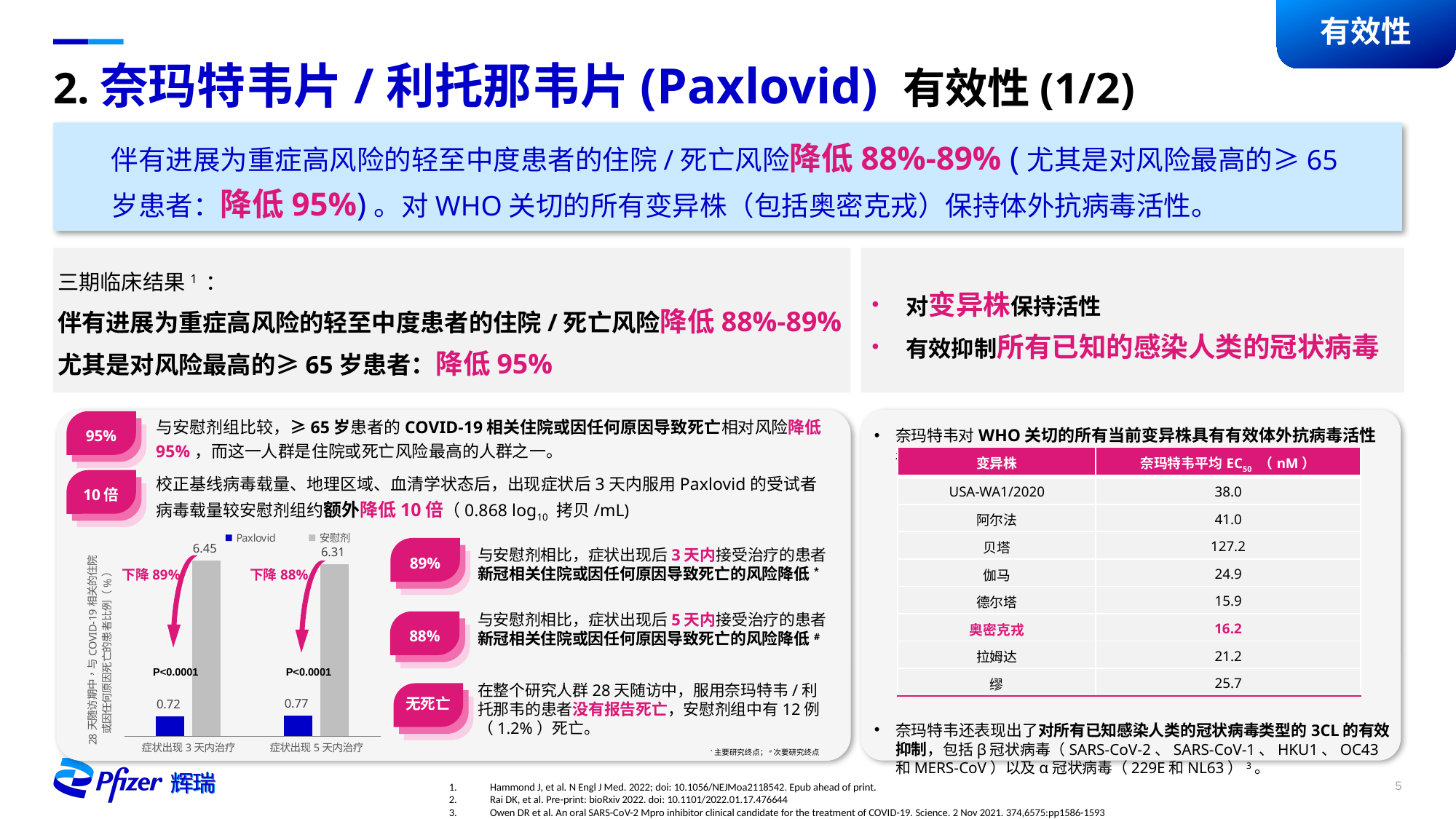
In the bar chart, what is the value for Paxlovid in the 症状出现 5 天内治疗 group? 0.77 In the bar chart, which bar has the highest value? 安慰剂, 症状出现 3 天内治疗 (6.45) In the bar chart, what is the value for 安慰剂 in the 症状出现 5 天内治疗 group? 6.31 In the bar chart, which bar has the lowest value? Paxlovid, 症状出现 3 天内治疗 (0.72) In the bar chart, what is the value for 安慰剂 in the 症状出现 3 天内治疗 group? 6.45 In the bar chart, what is the difference between the 安慰剂 and Paxlovid values in the 症状出现 3 天内治疗 group? 5.73 How many series does the legend of the bar chart list? 2 What type of chart is shown at the bottom left of the slide? bar chart In the bar chart, what is the value for Paxlovid in the 症状出现 3 天内治疗 group? 0.72 How many categories are shown on the x axis of the bar chart? 2 What percentage reduction is annotated above the 症状出现 5 天内治疗 group in the bar chart? 下降 88% In the bar chart, which is larger: the 安慰剂 value for 症状出现 3 天内治疗 or for 症状出现 5 天内治疗? 症状出现 3 天内治疗 (6.45)